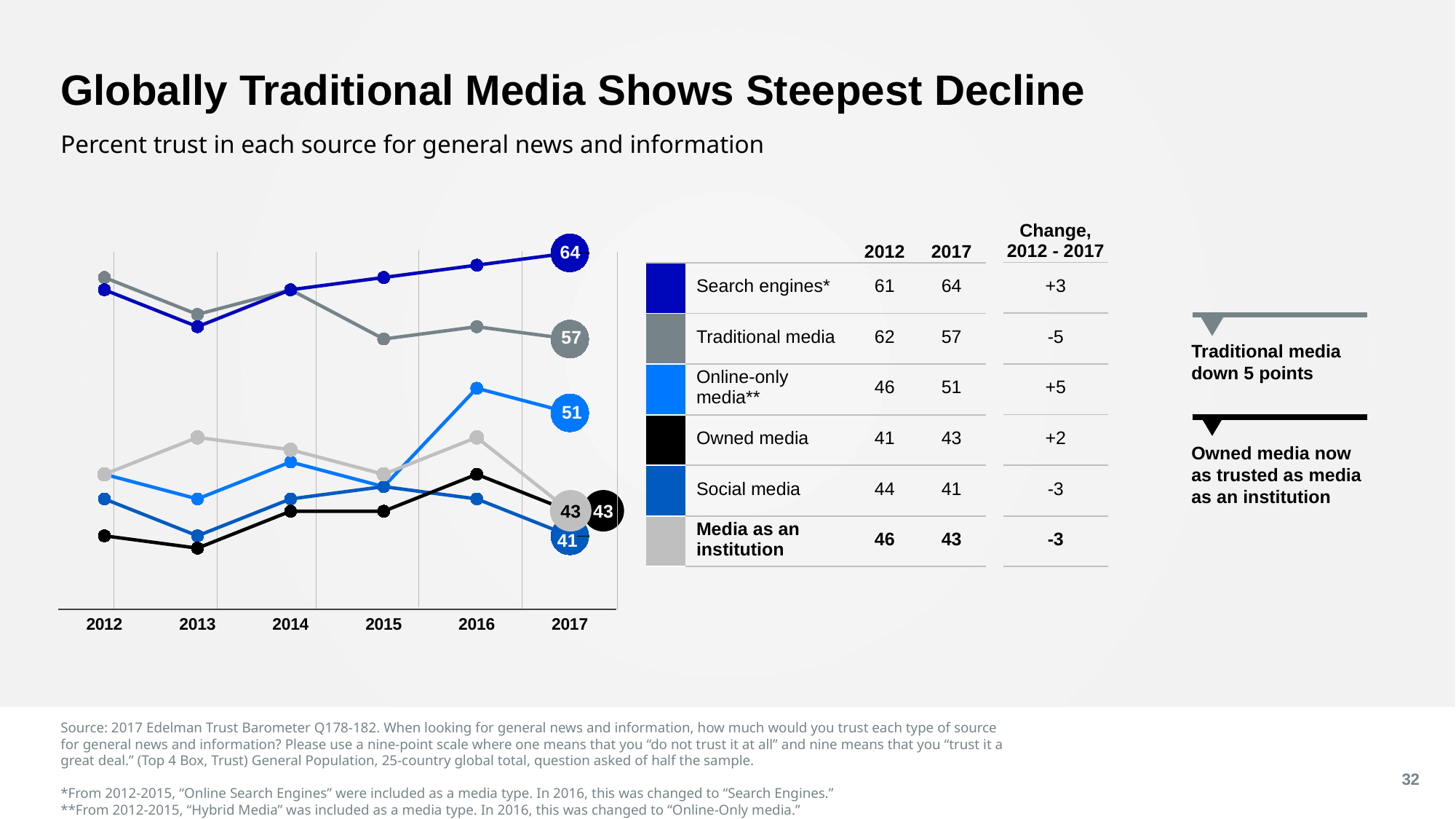
What is the difference between the 2017 values for Search engines and Traditional media? 7 What is the 2017 trust value for Traditional media? 57 Which source has the highest trust value in 2017? Search engines What is the 2017 trust value for Search engines? 64 How many sources (series) are plotted in the line chart? 6 What is the 2012 trust value for Online-only media? 46 Does the Traditional media line rise or fall from 2012 to 2017? fall Which source has the lowest trust value in 2017? Social media What type of chart is shown on the slide? line chart How many years are plotted along the x axis of the line chart? 6 What is the change from 2012 to 2017 for Social media shown in the table? -3 Which is larger in 2017, Online-only media or Owned media? Online-only media